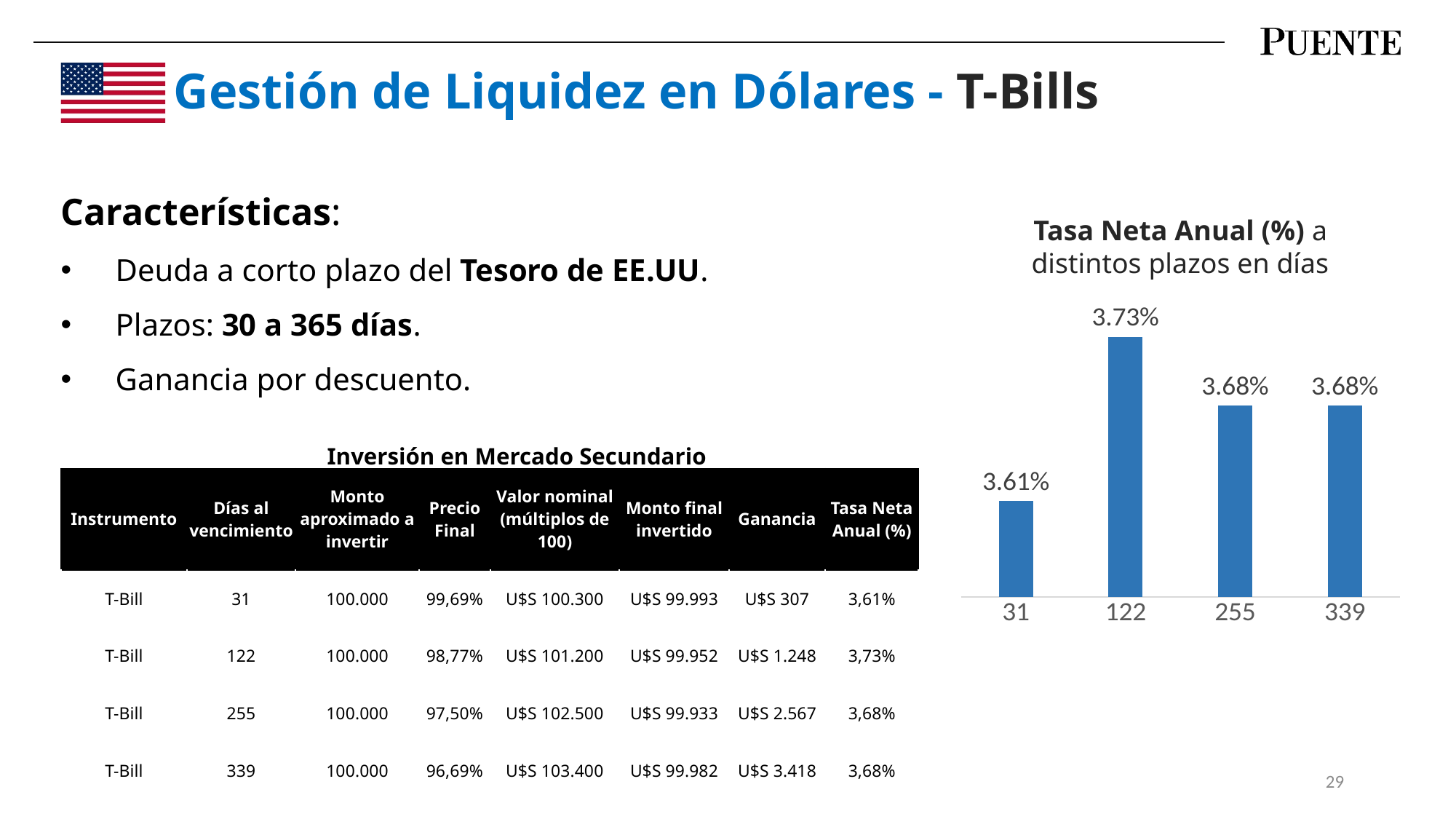
What is the title of the chart? Tasa Neta Anual (%) a distintos plazos en días What is the value for the 31-day term in the chart? 3.61% What is the difference between the values for the 122-day and 31-day terms in the chart? 0.12 percentage points Does the value rise or fall from the 31-day term to the 122-day term? Rise How many bars are shown in the chart? 4 Which is larger in the chart, the value for 31 days or the value for 255 days? 255 days What kind of chart is shown on the slide? Bar chart What is the value for the 255-day term in the chart? 3.68% Which term has the highest Tasa Neta Anual in the chart? 122 What is the value for the 339-day term in the chart? 3.68% Which term has the lowest Tasa Neta Anual in the chart? 31 What is the value for the 122-day term in the chart? 3.73%